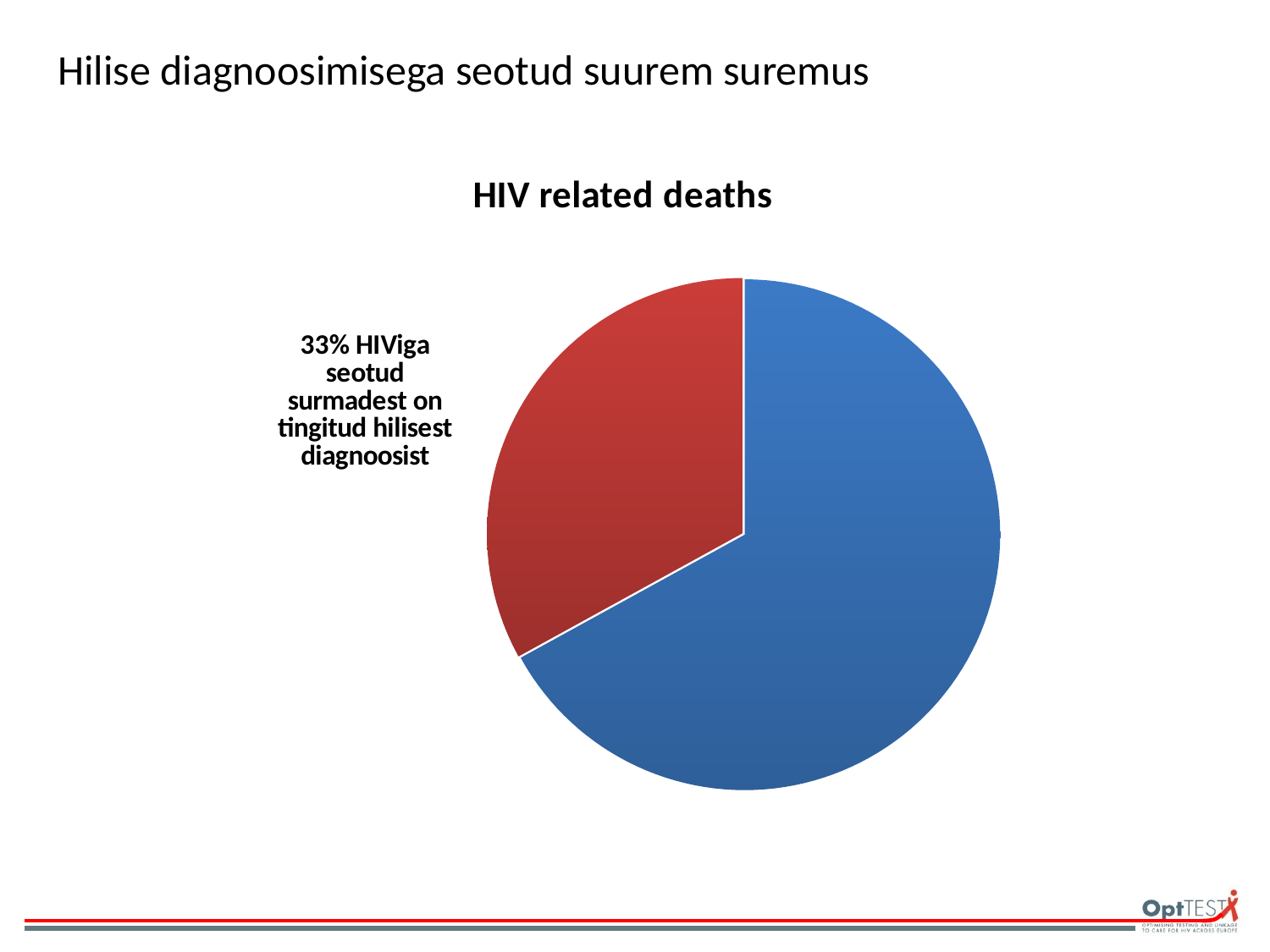
What share of HIV related deaths is attributed to late diagnosis according to the label on the chart? 33% Which slice is the largest in the pie chart? the blue slice How many slices does the pie chart have? 2 What is the title of the chart? HIV related deaths What colour is the slice labelled '33% HIViga seotud surmadest on tingitud hilisest diagnoosist'? red What percentage is printed in the label next to the red slice? 33% Is the red slice greater or less than half of the pie? less Which slice of the pie is larger, the blue one or the red one? blue Which slice is the smallest in the pie chart? the red slice (33%) What kind of chart is shown on the slide? pie chart Is the blue slice greater or less than half of the pie? greater